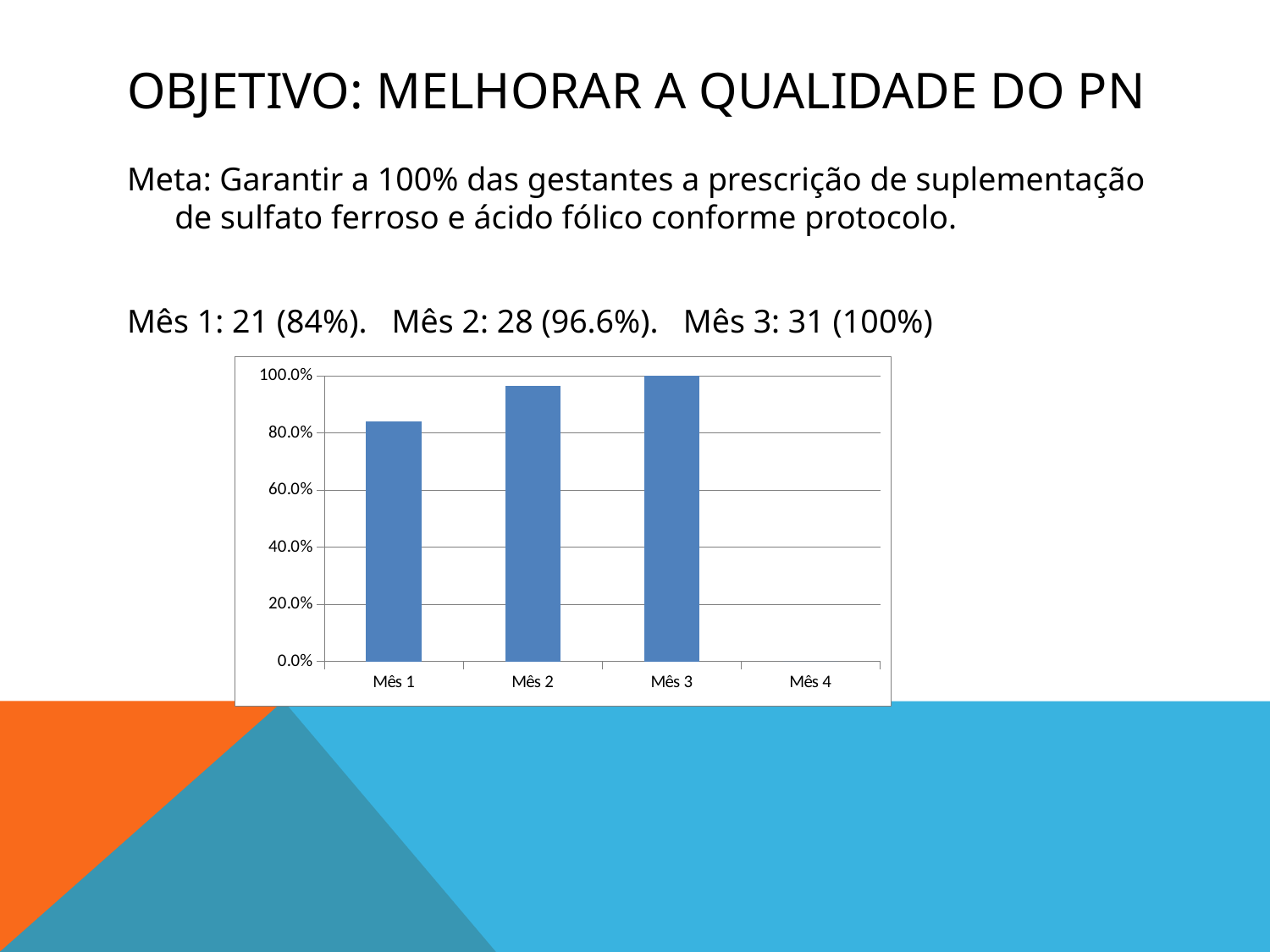
Is the value for Mês 2 greater or less than 100.0%? less Which category on the x axis has no bar plotted? Mês 4 Which is larger, the value for Mês 2 or the value for Mês 3? Mês 3 Which month has the highest bar in the chart? Mês 3 How many bars are plotted in the chart? 3 According to the slide, what percentage is shown for Mês 3? 100% What kind of chart is shown on the slide? bar chart Is the value for Mês 1 greater or less than 80.0%? greater How many categories are shown on the x axis of the chart? 4 Which month with a plotted bar has the lowest value? Mês 1 According to the slide, what percentage is shown for Mês 2? 96.6% Do the bar values rise or fall from Mês 1 to Mês 3? rise